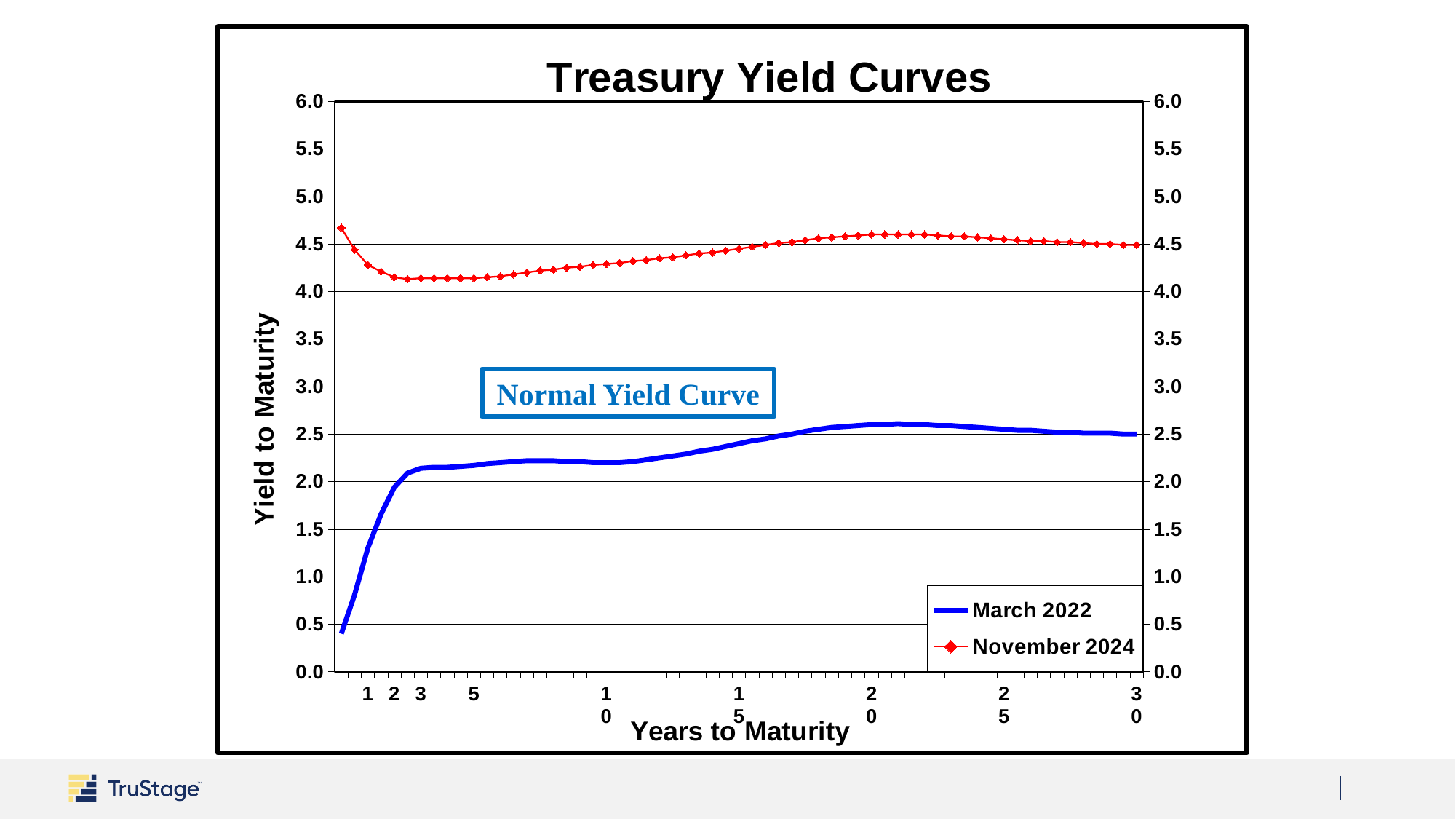
How many series does the legend list? 2 Is the March 2022 value at 1 year to maturity greater or less than 2.0? less What is the label of the vertical axis? Yield to Maturity Does the November 2024 curve rise or fall between 1 and 3 years to maturity? fall What kind of chart is shown on the slide? line chart Which series is plotted higher across all maturities, March 2022 or November 2024? November 2024 Does the March 2022 curve rise or fall between 1 and 10 years to maturity? rise What is the title of the chart? Treasury Yield Curves Is the November 2024 value at 1 year to maturity greater or less than 4.0? greater At 30 years to maturity, which series has the larger value, March 2022 or November 2024? November 2024 Is the November 2024 value at 10 years to maturity greater or less than 4.5? less